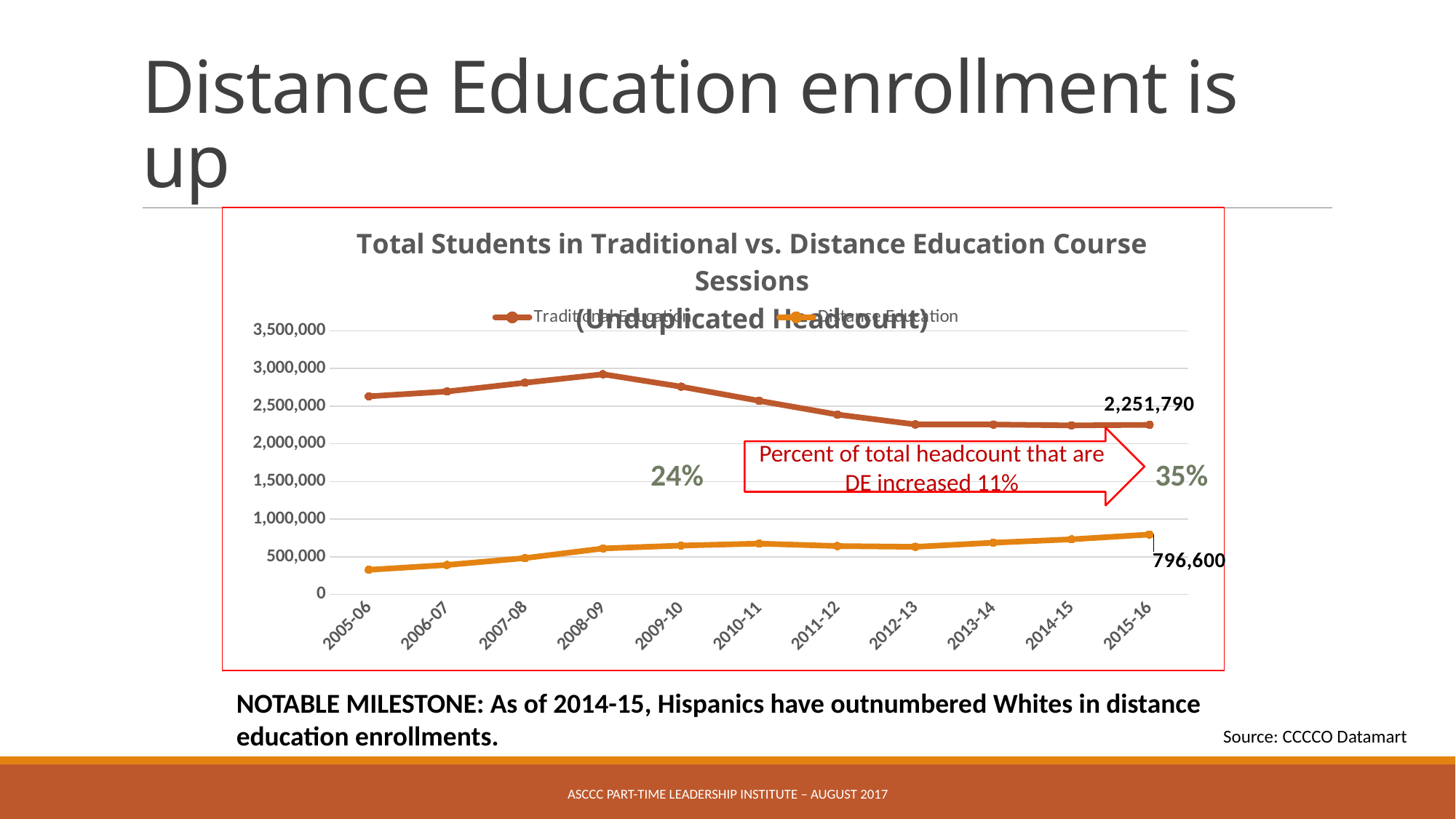
In which year does the Distance Education series have its lowest value? 2005-06 How many series does the legend list? 2 In 2015-16, which series has the larger value, Traditional Education or Distance Education? Traditional Education What is the difference between the Traditional Education and Distance Education values in 2015-16? 1,455,190 What is the Traditional Education value for 2015-16? 2,251,790 Is the Traditional Education value for 2008-09 greater or less than 2,500,000? greater What is the Distance Education value for 2015-16? 796,600 In which year does the Traditional Education series reach its highest value? 2008-09 What kind of chart is shown on the slide? Line chart Is the Distance Education value for 2010-11 greater or less than 1,000,000? less Does the Distance Education series rise or fall overall from 2005-06 to 2015-16? Rise How many academic years are shown on the x axis? 11